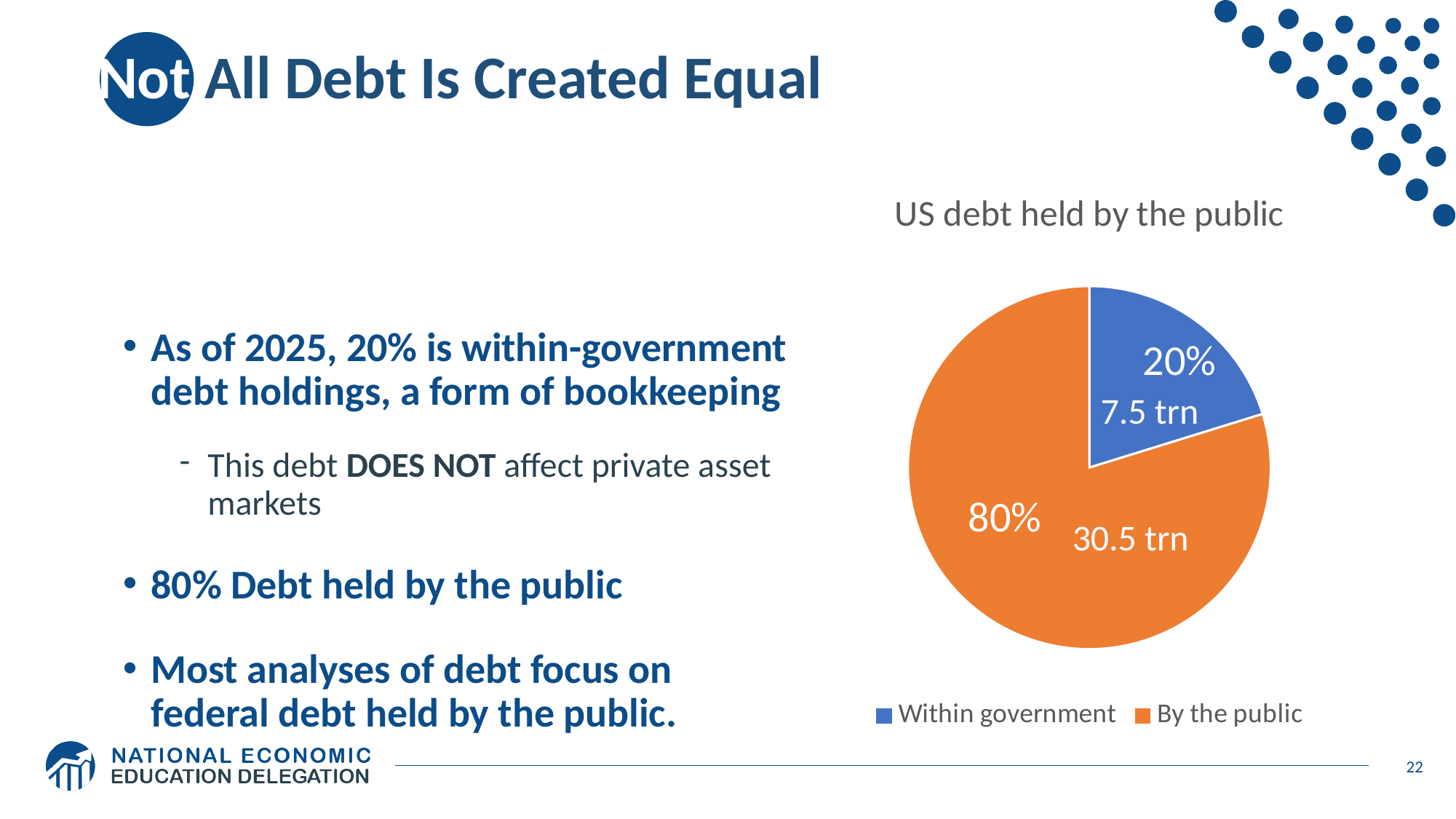
What value is printed on the 'Within government' slice? 7.5 trn What percentage of the pie is labelled for the 'Within government' slice? 20% Which is larger, the 'Within government' slice or the 'By the public' slice? By the public What kind of chart is shown on the slide? Pie chart How many slices does the pie chart have? 2 What value is printed on the 'By the public' slice? 30.5 trn What colour is the 'By the public' slice? Orange Which slice of the pie is the largest? By the public Which slice of the pie is the smallest? Within government What is the title of the chart? US debt held by the public What is the difference in trillions between the 'By the public' value and the 'Within government' value? 23 trn What percentage of the pie is labelled for the 'By the public' slice? 80%